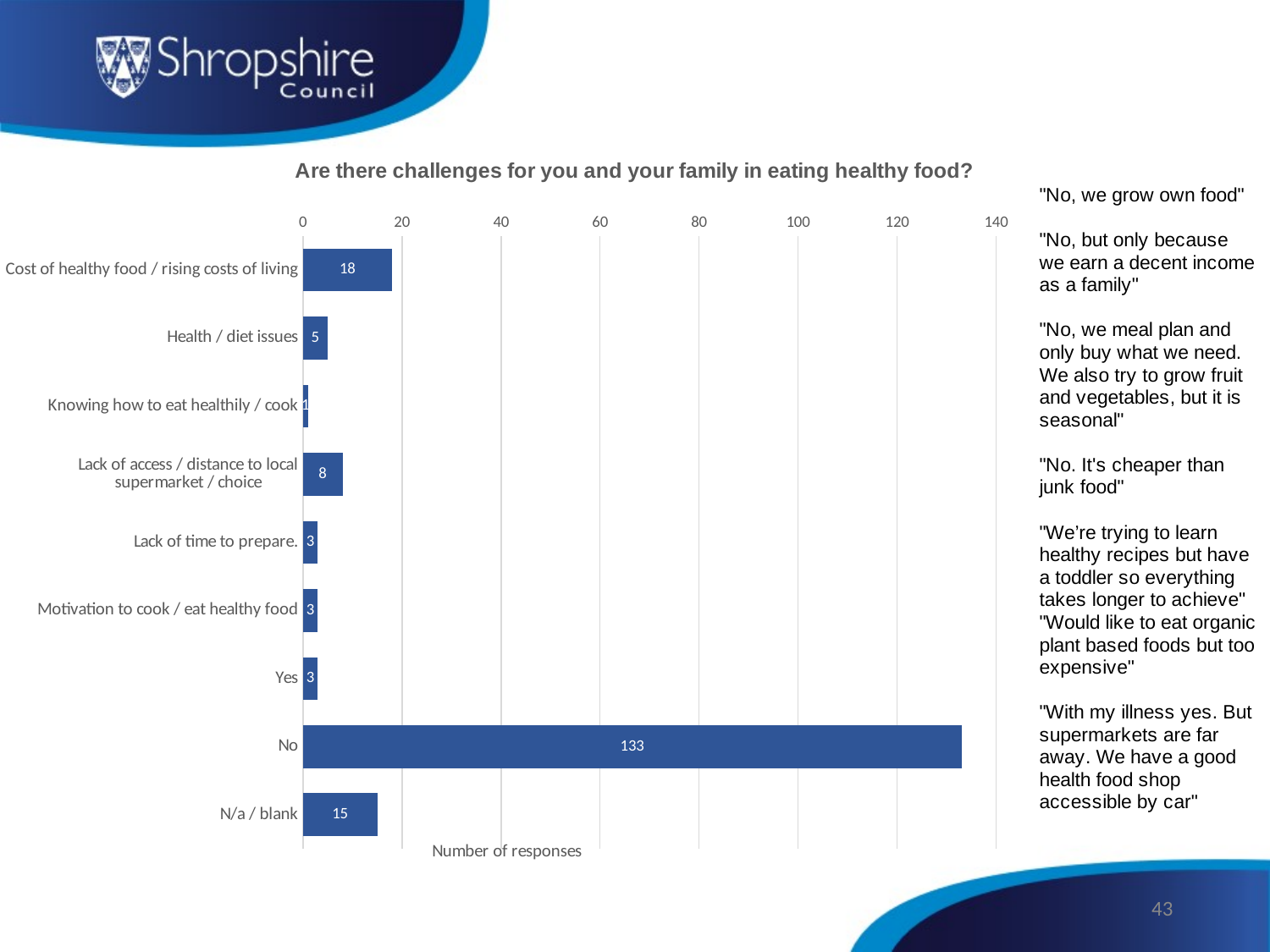
Is the value for "No" greater or less than 120? greater What is the number of responses for "Cost of healthy food / rising costs of living"? 18 What kind of chart is shown on the slide? Bar chart What is the number of responses for "No"? 133 How many categories are shown in the chart? 9 What is the number of responses for "Lack of access / distance to local supermarket / choice"? 8 Which category has the highest number of responses? No What is the label of the horizontal axis? Number of responses What is the difference in responses between "No" and "Cost of healthy food / rising costs of living"? 115 What is the number of responses for "N/a / blank"? 15 Which has more responses, "Health / diet issues" or "Lack of access / distance to local supermarket / choice"? Lack of access / distance to local supermarket / choice Which category has the lowest number of responses? Knowing how to eat healthily / cook